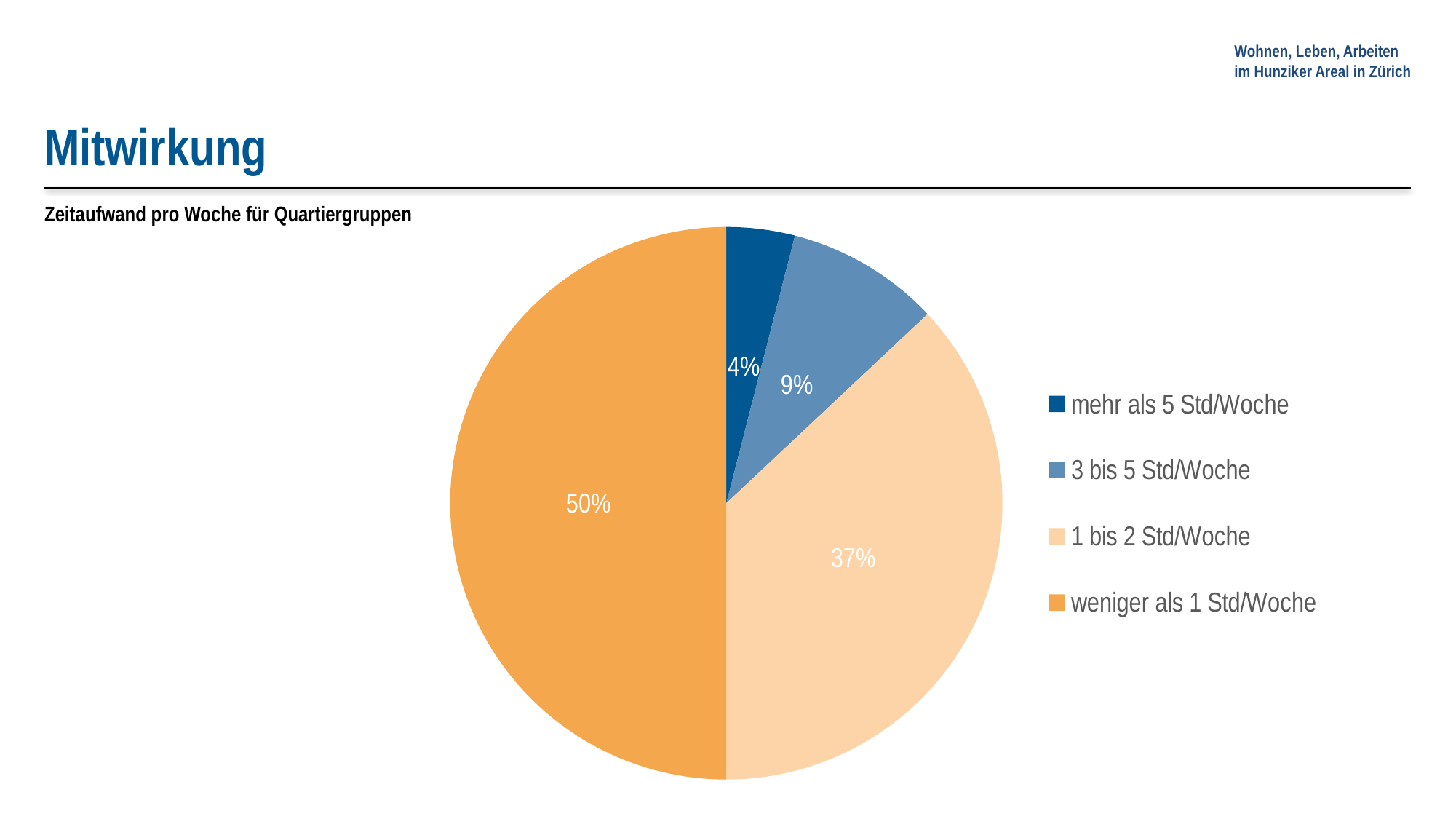
Which colour is used for the 'mehr als 5 Std/Woche' slice? dark blue What is the subtitle printed above the chart? Zeitaufwand pro Woche für Quartiergruppen What share of the pie is '1 bis 2 Std/Woche'? 37% What share of the pie is 'weniger als 1 Std/Woche'? 50% What share of the pie is '3 bis 5 Std/Woche'? 9% How many categories does the pie chart have? 4 What is the difference in percentage points between 'weniger als 1 Std/Woche' and '1 bis 2 Std/Woche'? 13 Which category has the smallest slice of the pie? mehr als 5 Std/Woche Which is larger: '3 bis 5 Std/Woche' or 'mehr als 5 Std/Woche'? 3 bis 5 Std/Woche Which category has the largest slice of the pie? weniger als 1 Std/Woche What kind of chart is shown on the slide? pie chart